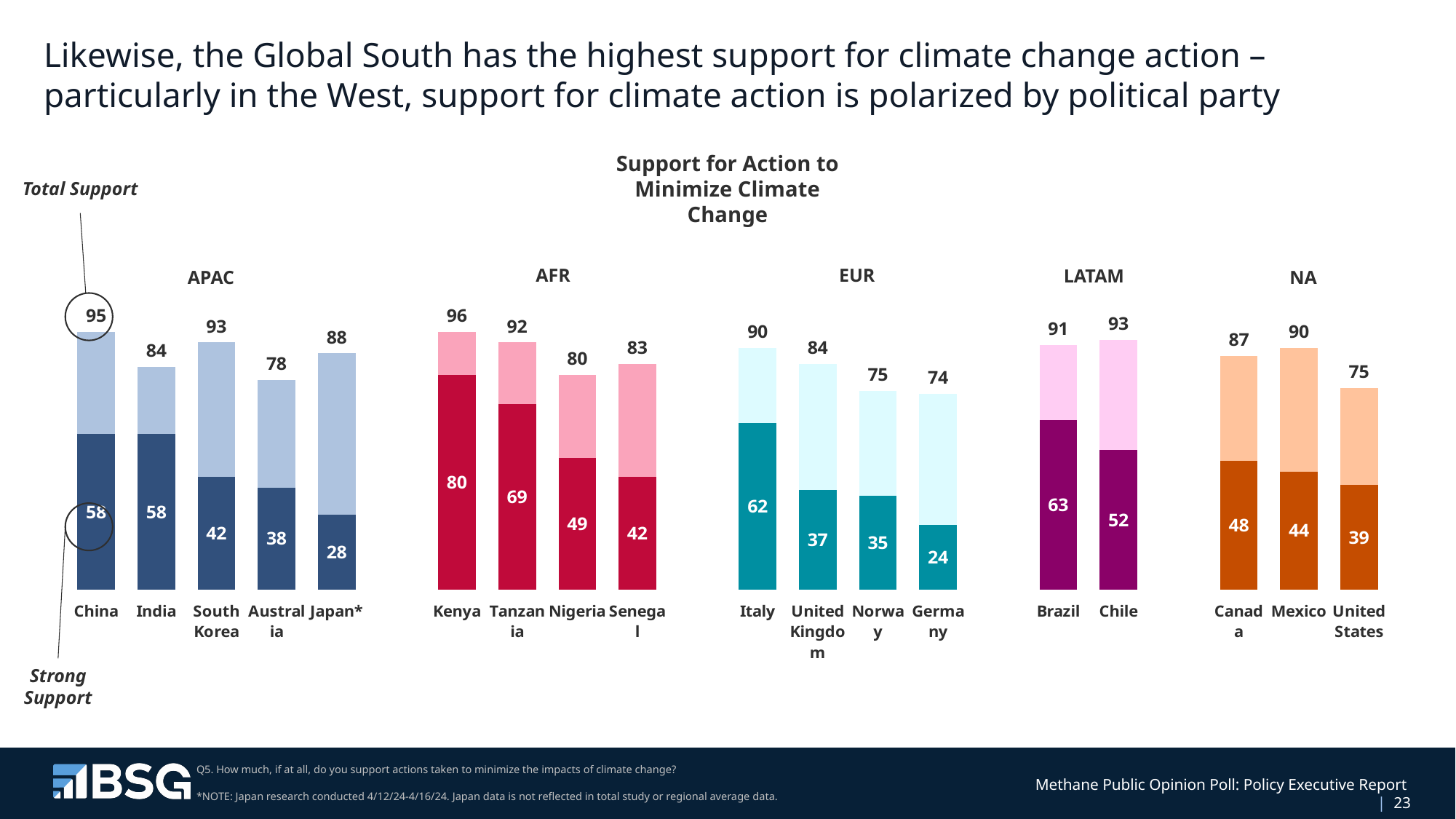
What kind of chart is used to show support for action to minimize climate change? Stacked bar chart What is the difference between total support and strong support for Japan? 60 How many countries are shown in the chart? 18 Which has a higher total support value, Brazil or Chile? Chile What is the strong support value for Germany? 24 How many regional groups are shown in the chart? 5 Which country has the lowest strong support value? Germany Which region's panel is labeled LATAM? The one with Brazil and Chile Which country has the highest total support for action to minimize climate change? Kenya What is the total support value for the United States? 75 What is the difference in strong support between Kenya and Tanzania? 11 What is the total support value for Kenya? 96